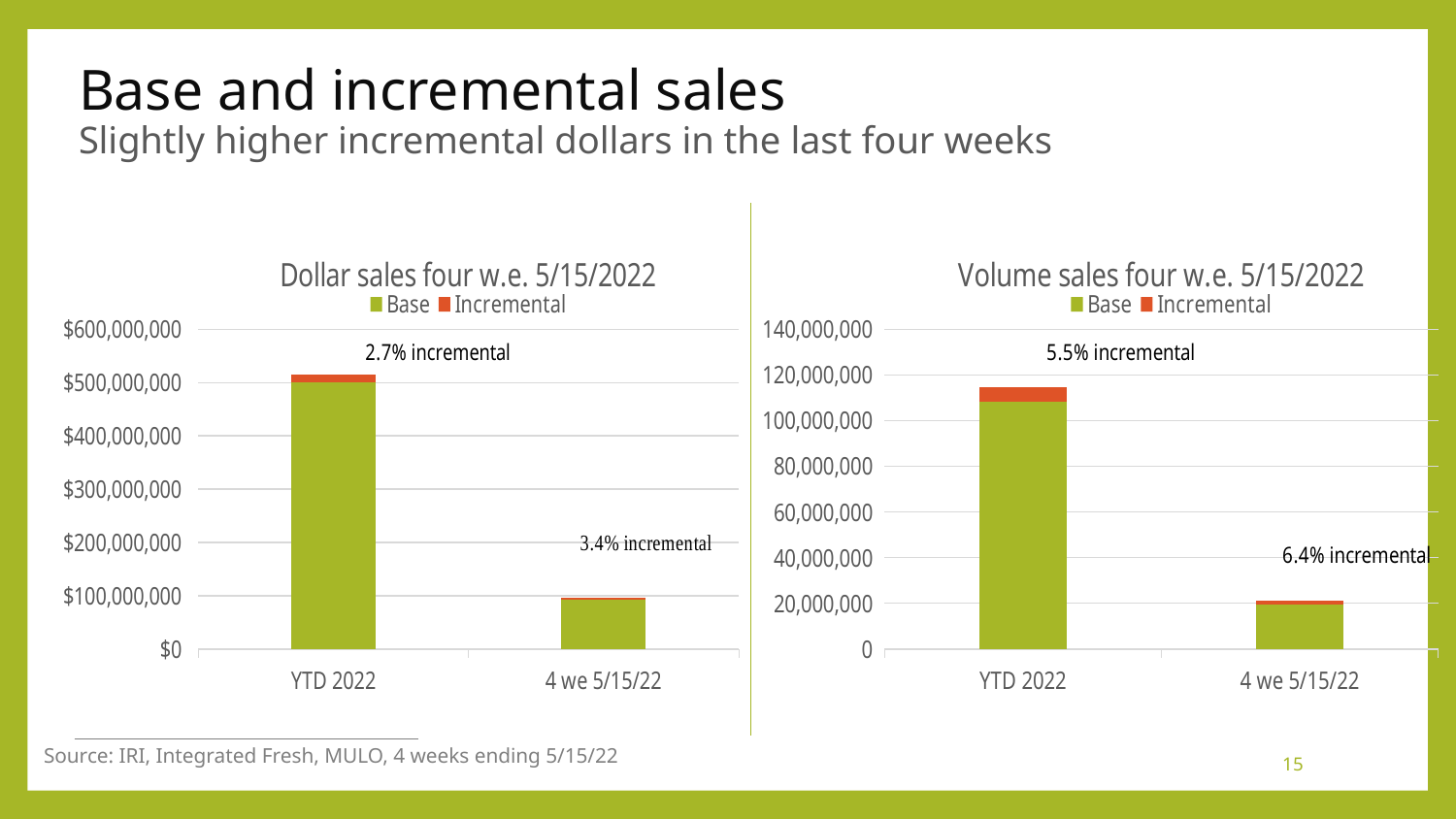
What are the two series named in the legend of the 'Dollar sales four w.e. 5/15/2022' chart? Base and Incremental In the 'Dollar sales four w.e. 5/15/2022' chart, which category has the taller total bar? YTD 2022 In the 'Volume sales four w.e. 5/15/2022' chart, which category has the shorter total bar? 4 we 5/15/22 What type of chart is the 'Dollar sales four w.e. 5/15/2022' chart? Stacked bar chart In the 'Volume sales four w.e. 5/15/2022' chart, what incremental percentage is labelled for 4 we 5/15/22? 6.4% incremental In the 'Dollar sales four w.e. 5/15/2022' chart, what incremental percentage is labelled for 4 we 5/15/22? 3.4% incremental How many series does the legend of the 'Volume sales four w.e. 5/15/2022' chart list? 2 In the 'Volume sales four w.e. 5/15/2022' chart, what incremental percentage is labelled for YTD 2022? 5.5% incremental In the 'Dollar sales four w.e. 5/15/2022' chart, is the total for YTD 2022 greater or less than $400,000,000? greater In the 'Volume sales four w.e. 5/15/2022' chart, is the total for 4 we 5/15/22 greater or less than 40,000,000? less How many categories are shown on the x axis of the 'Dollar sales four w.e. 5/15/2022' chart? 2 In the 'Dollar sales four w.e. 5/15/2022' chart, what incremental percentage is labelled for YTD 2022? 2.7% incremental